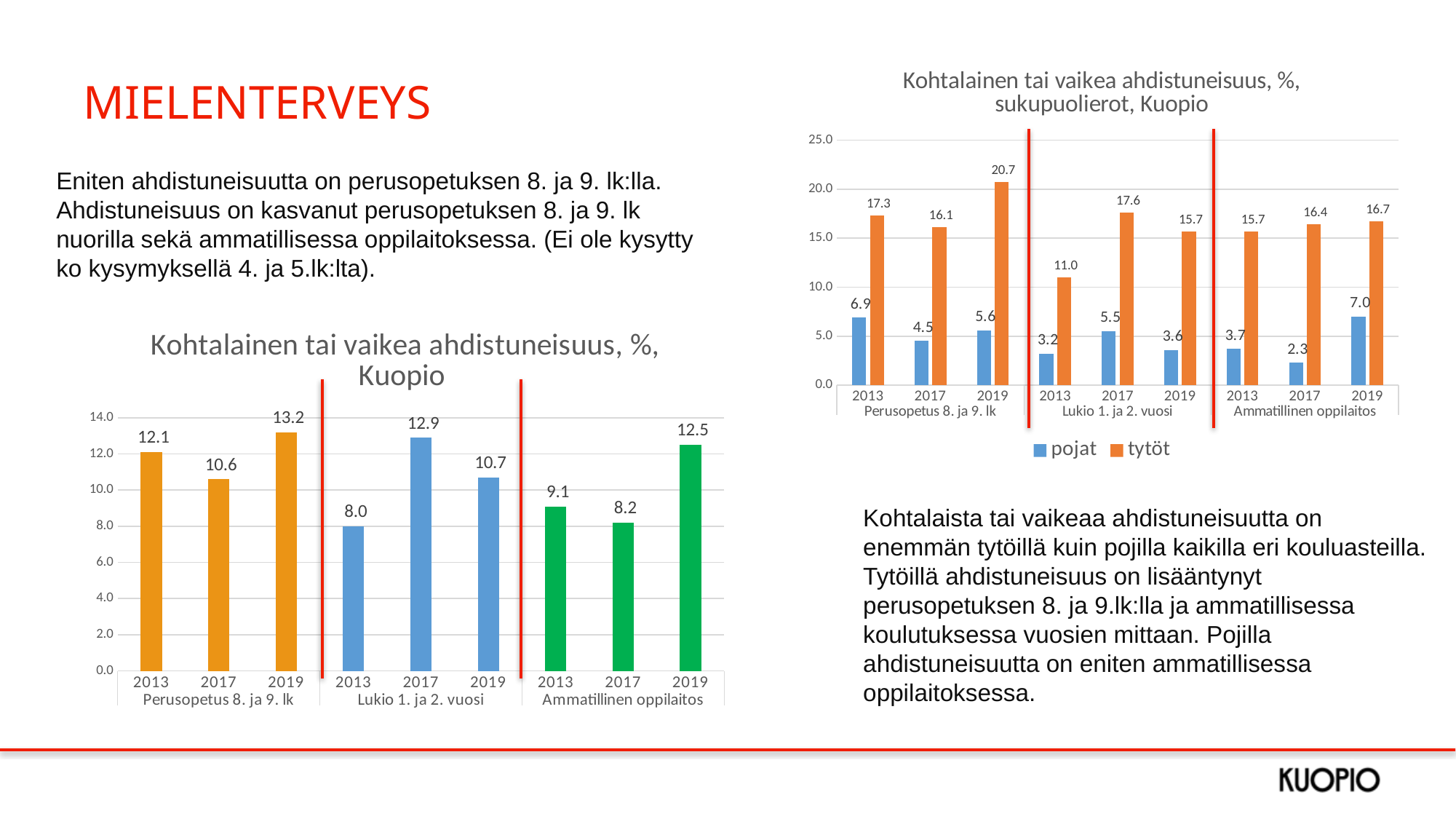
What kind of chart is the right chart 'Kohtalainen tai vaikea ahdistuneisuus, %, sukupuolierot, Kuopio'? Bar chart In the right chart 'Kohtalainen tai vaikea ahdistuneisuus, %, sukupuolierot, Kuopio', what is the difference between tytöt and pojat in Perusopetus 8. ja 9. lk in 2013? 10.4 In the left chart 'Kohtalainen tai vaikea ahdistuneisuus, %, Kuopio', what is the value for Lukio 1. ja 2. vuosi in 2013? 8.0 In the right chart 'Kohtalainen tai vaikea ahdistuneisuus, %, sukupuolierot, Kuopio', how many series does the legend list? 2 In the left chart 'Kohtalainen tai vaikea ahdistuneisuus, %, Kuopio', how many bars are plotted in total? 9 In the left chart 'Kohtalainen tai vaikea ahdistuneisuus, %, Kuopio', what is the difference between the Ammatillinen oppilaitos values for 2019 and 2017? 4.3 In the left chart 'Kohtalainen tai vaikea ahdistuneisuus, %, Kuopio', what is the value for Perusopetus 8. ja 9. lk in 2019? 13.2 In the left chart 'Kohtalainen tai vaikea ahdistuneisuus, %, Kuopio', which bar has the highest value? Perusopetus 8. ja 9. lk, 2019 (13.2) In the right chart 'Kohtalainen tai vaikea ahdistuneisuus, %, sukupuolierot, Kuopio', what is the value for pojat in Ammatillinen oppilaitos in 2017? 2.3 In the right chart 'Kohtalainen tai vaikea ahdistuneisuus, %, sukupuolierot, Kuopio', which is larger in Lukio 1. ja 2. vuosi in 2017: pojat or tytöt? tytöt In the left chart 'Kohtalainen tai vaikea ahdistuneisuus, %, Kuopio', which bar has the lowest value? Lukio 1. ja 2. vuosi, 2013 (8.0) In the right chart 'Kohtalainen tai vaikea ahdistuneisuus, %, sukupuolierot, Kuopio', what is the value for tytöt in Perusopetus 8. ja 9. lk in 2019? 20.7